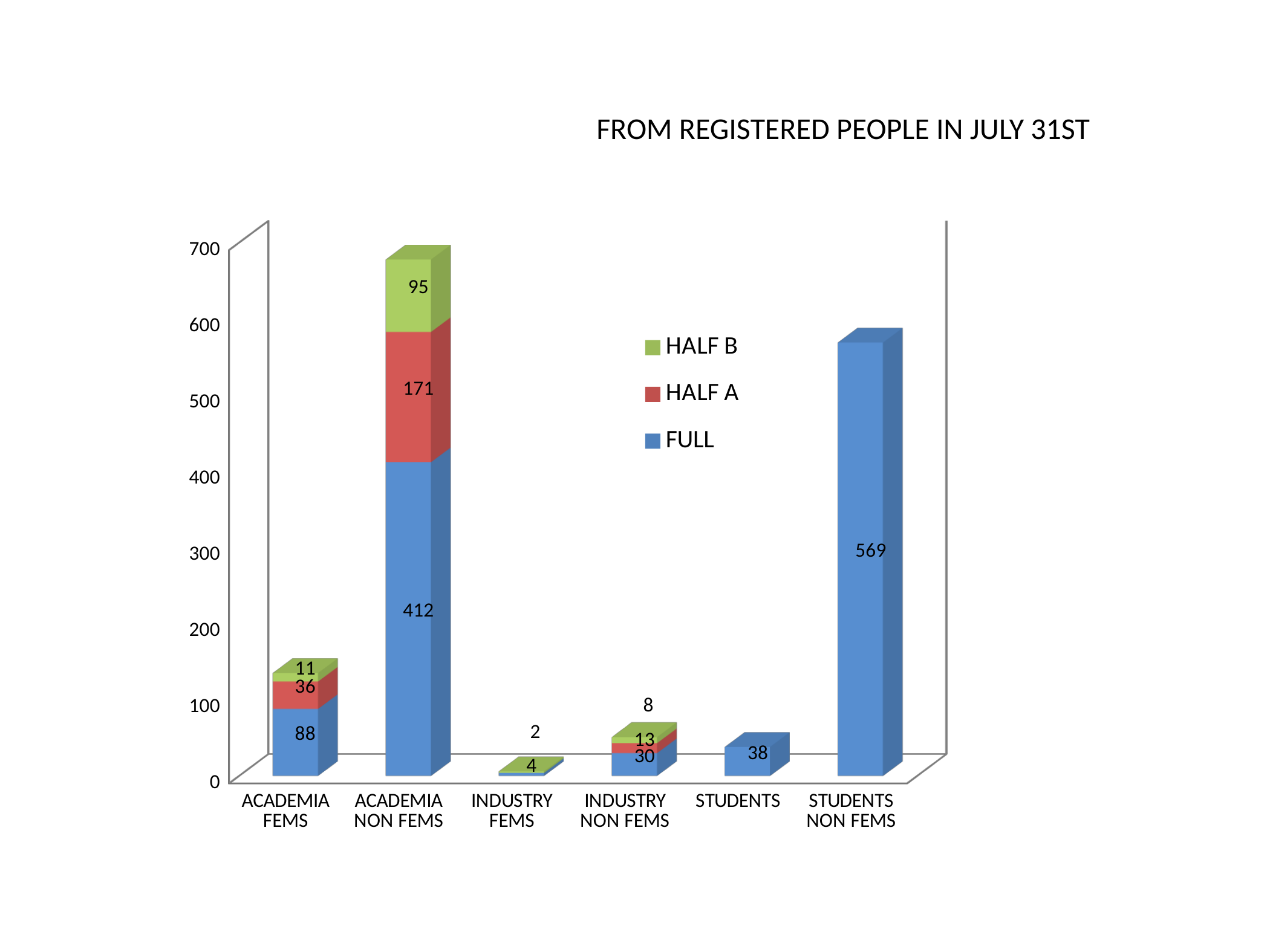
What is the FULL value for ACADEMIA NON FEMS? 412 What is the HALF A value for ACADEMIA FEMS? 36 Which category has the tallest stacked bar overall? ACADEMIA NON FEMS How many series does the legend list? 3 For ACADEMIA NON FEMS, which is larger: the HALF A value or the HALF B value? HALF A How many categories are shown on the x axis? 6 What is the total of the stacked bar for ACADEMIA FEMS? 135 Which category has the shortest stacked bar overall? INDUSTRY FEMS What is the HALF B value for INDUSTRY NON FEMS? 8 What is the total of the stacked bar for ACADEMIA NON FEMS? 678 What is the difference between the FULL value for STUDENTS NON FEMS and the FULL value for ACADEMIA NON FEMS? 157 What is the FULL value for STUDENTS NON FEMS? 569